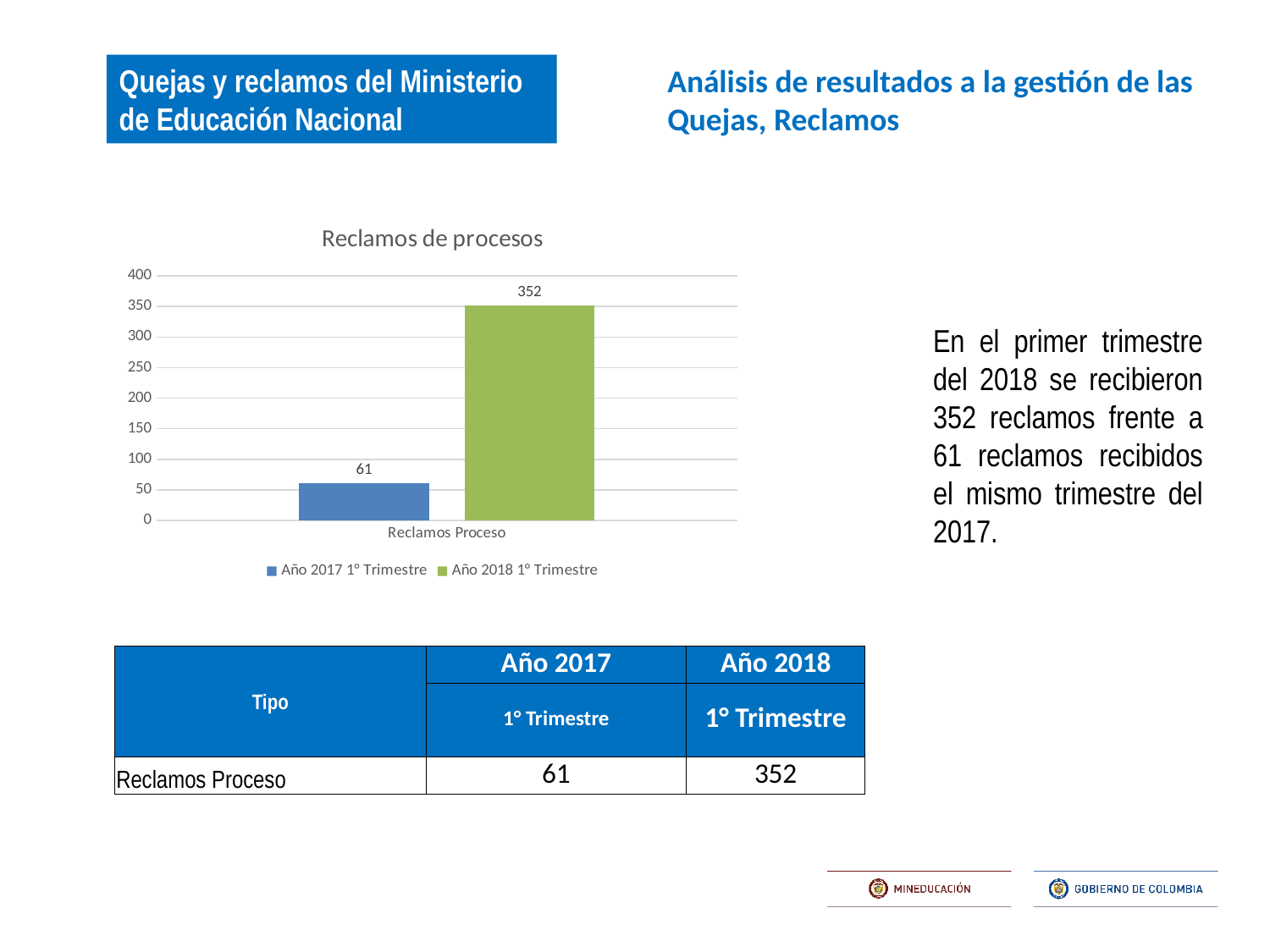
What is the value for Año 2018 1° Trimestre in the Reclamos de procesos chart? 352 Which series has the lower value in the Reclamos de procesos chart? Año 2017 1° Trimestre What is the difference between the Año 2018 1° Trimestre and Año 2017 1° Trimestre values in the chart? 291 Is the value for Año 2018 1° Trimestre greater or less than 300? greater What is the title of the chart on the slide? Reclamos de procesos Which series has the higher value in the Reclamos de procesos chart? Año 2018 1° Trimestre Is the value for Año 2017 1° Trimestre larger or smaller than the value for Año 2018 1° Trimestre? smaller What kind of chart is shown on the slide? bar chart How many categories are shown on the x axis of the chart? 1 How many series does the legend of the chart list? 2 What is the value for Año 2017 1° Trimestre in the Reclamos de procesos chart? 61 Is the value for Año 2017 1° Trimestre greater or less than 100? less